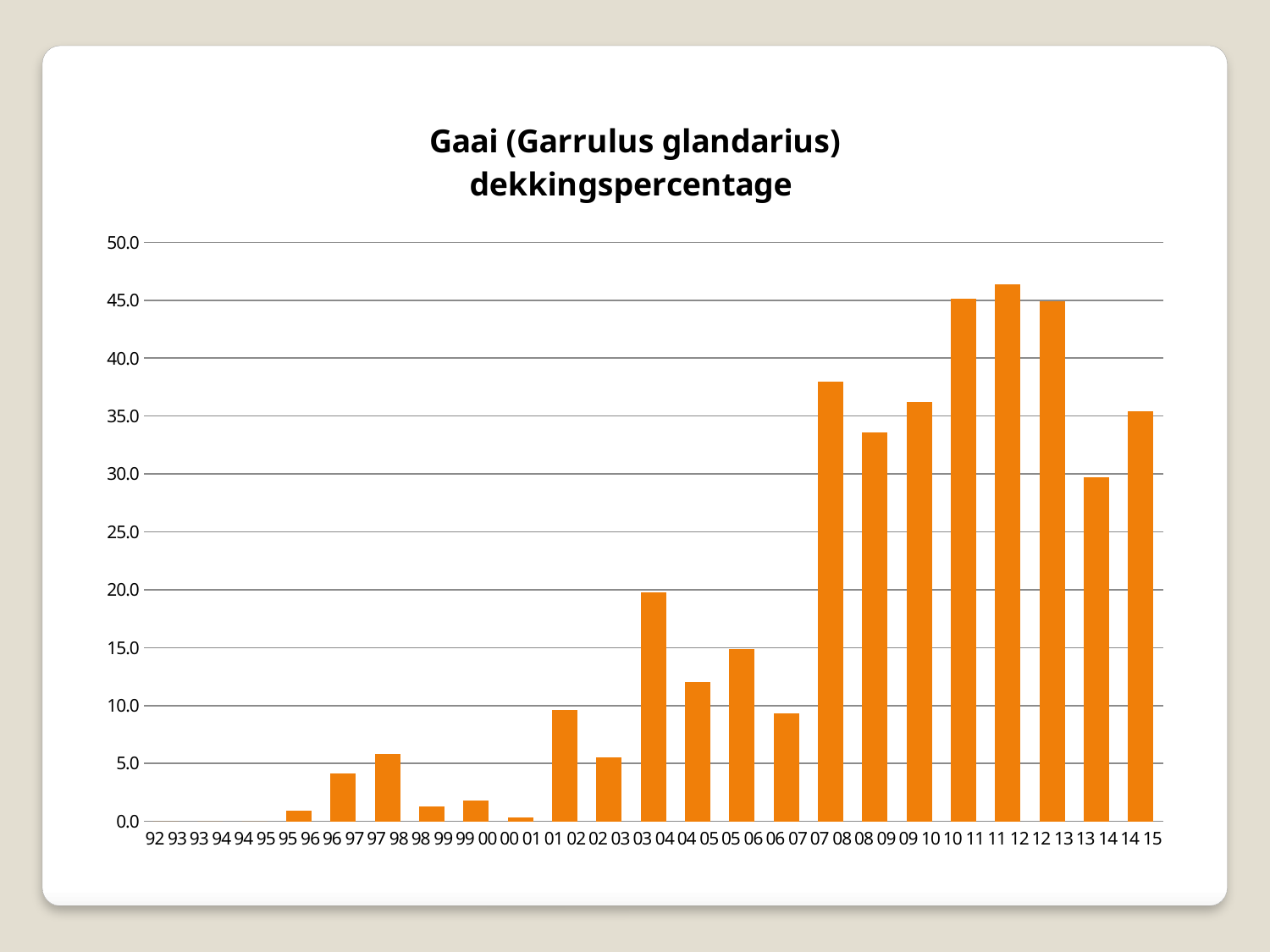
Is the value for 08 09 greater or less than 35.0? less Is the value for 04 05 greater or less than 10.0? greater What is the title of the chart? Gaai (Garrulus glandarius) dekkingspercentage Overall, do the values rise or fall from the earliest season to the latest season? rise Is the value for 13 14 greater or less than 25.0? greater How many season categories are shown on the x axis? 23 Which is larger, the value for 07 08 or the value for 08 09? 07 08 What kind of chart is shown on the slide? bar chart Which is larger, the value for 12 13 or the value for 13 14? 12 13 Which season has the highest dekkingspercentage? 11 12